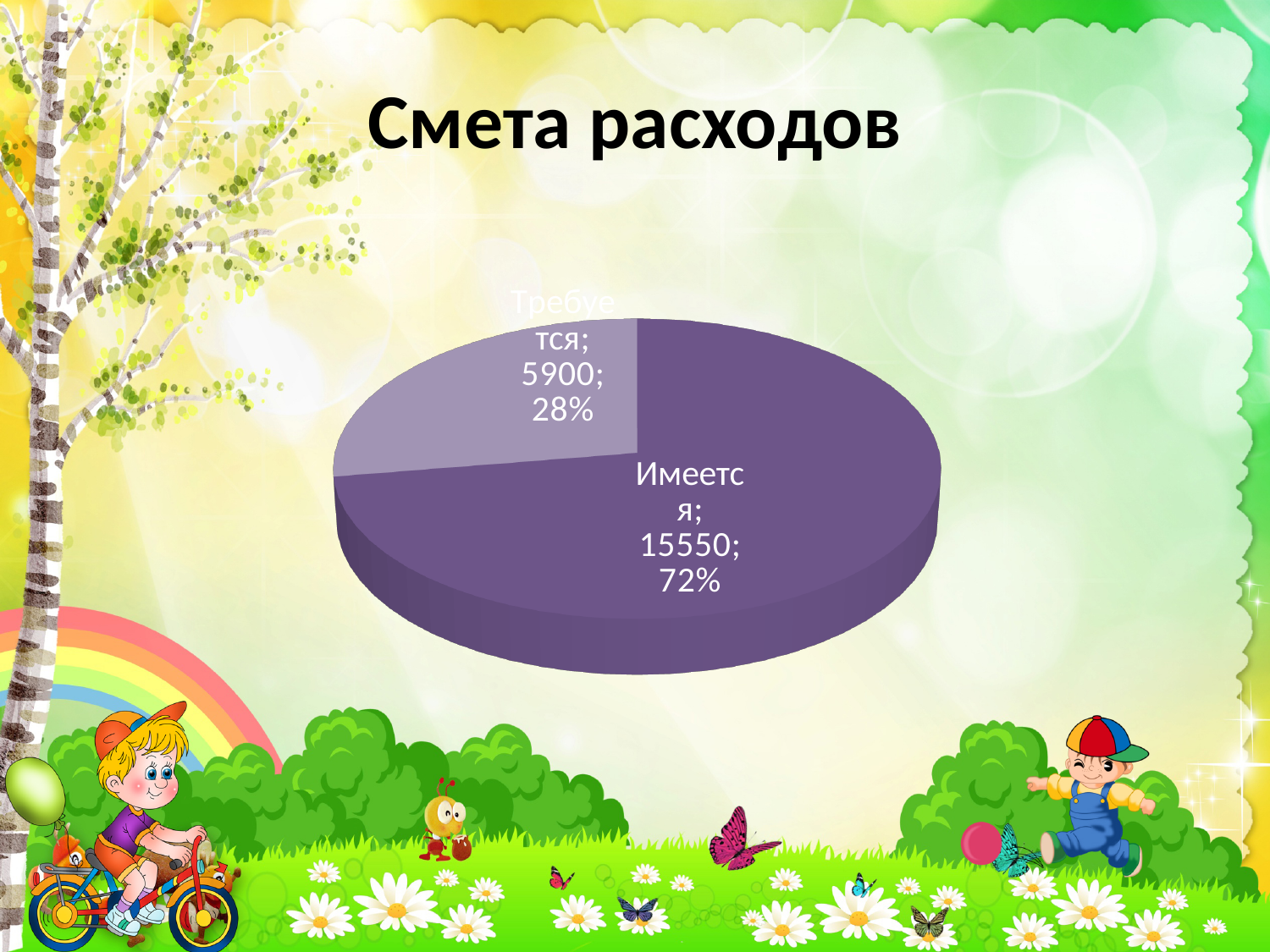
What is the value for Имеется? 15550 What is the difference between the values for Имеется and Требуется? 9650 What is the total of the two slices? 21450 Which slice is the largest? Имеется What type of chart is shown on the slide? pie chart What is the title of the slide containing the chart? Смета расходов What share of the pie does the Требуется slice represent? 28% How many slices does the pie chart have? 2 What share of the pie does the Имеется slice represent? 72% Which slice is the smallest? Требуется Which is larger, Имеется or Требуется? Имеется What is the value for Требуется? 5900